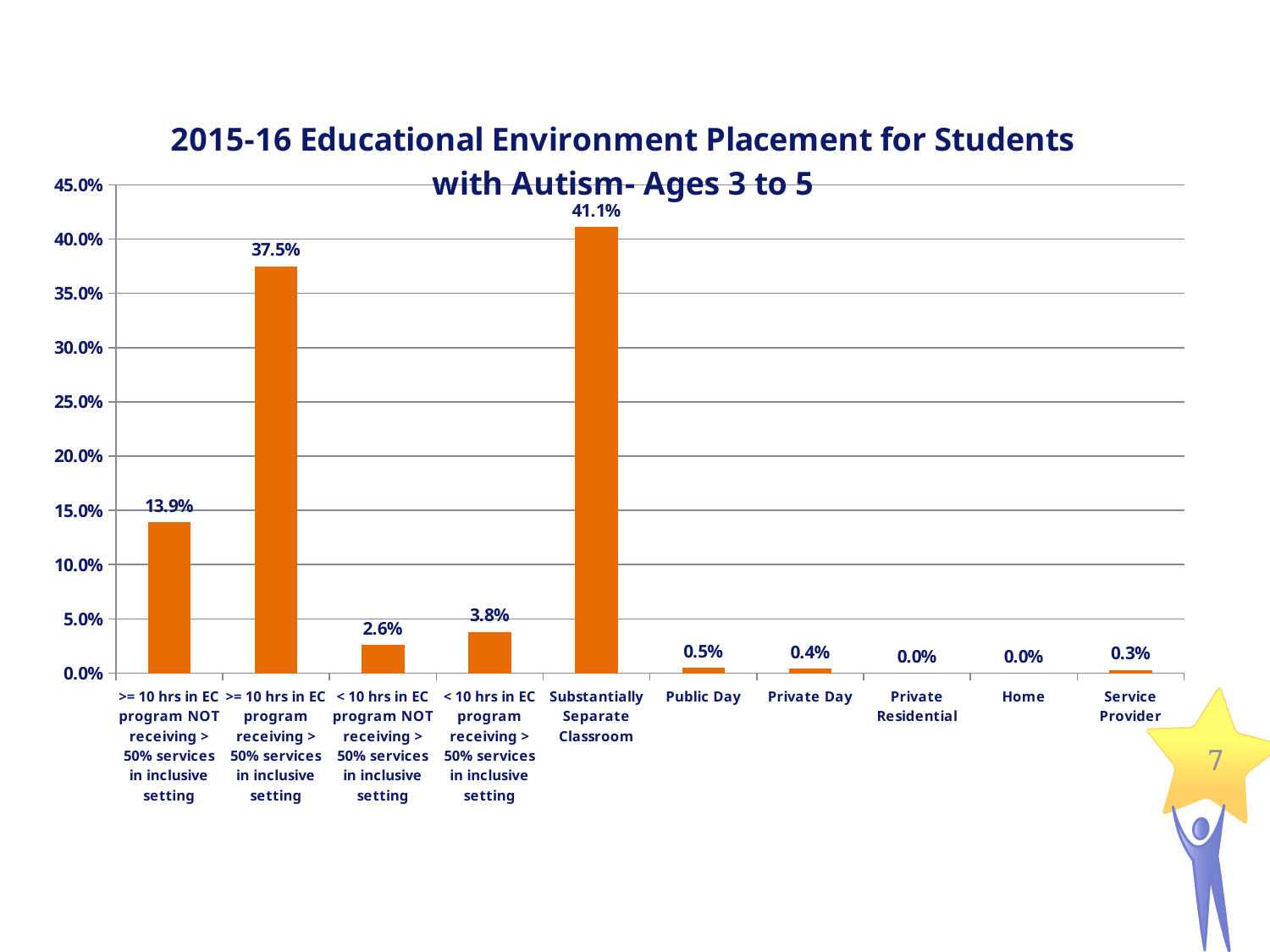
Is the value for '>= 10 hrs in EC program receiving > 50% services in inclusive setting' greater or less than 35.0%? greater What kind of chart is this? Bar chart Which is larger: '< 10 hrs in EC program NOT receiving > 50% services in inclusive setting' or '< 10 hrs in EC program receiving > 50% services in inclusive setting'? < 10 hrs in EC program receiving > 50% services in inclusive setting What is the value for Substantially Separate Classroom? 41.1% What is the value for Service Provider? 0.3% What is the difference between Substantially Separate Classroom and '>= 10 hrs in EC program receiving > 50% services in inclusive setting'? 3.6% How many categories are shown on the x axis? 10 What is the total of Public Day and Private Day? 0.9% What is the value for '>= 10 hrs in EC program NOT receiving > 50% services in inclusive setting'? 13.9% What is the title of the chart? 2015-16 Educational Environment Placement for Students with Autism- Ages 3 to 5 What is the value for Public Day? 0.5% Which category has the highest value? Substantially Separate Classroom